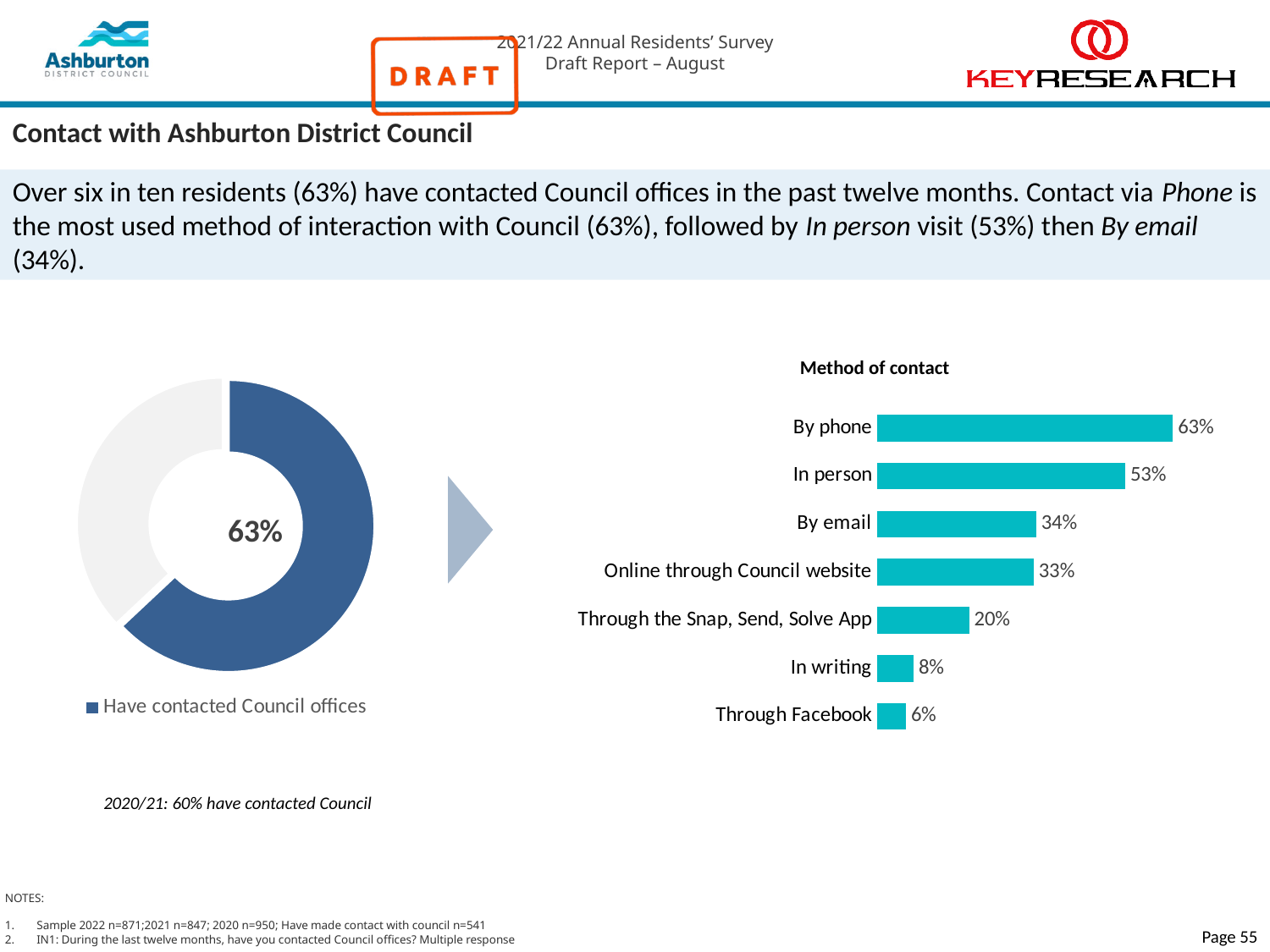
In the donut chart on the left, what percentage have contacted Council offices? 63% What is the legend entry shown below the donut chart on the left? Have contacted Council offices What kind of chart is the 'Method of contact' chart on the right? Bar chart In the 'Method of contact' bar chart, which method has the lowest value? Through Facebook In the 'Method of contact' bar chart, what is the difference between By email and In writing? 26% In the 'Method of contact' bar chart, what is the value for Online through Council website? 33% In the 'Method of contact' bar chart, which method has the highest value? By phone In the 'Method of contact' bar chart, what is the value for Through the Snap, Send, Solve App? 20% In the 'Method of contact' bar chart, what is the difference between By phone and In person? 10% How many methods of contact are shown in the 'Method of contact' bar chart? 7 In the 'Method of contact' bar chart, what is the value for By phone? 63% In the 'Method of contact' bar chart, which is larger: In writing or Through Facebook? In writing